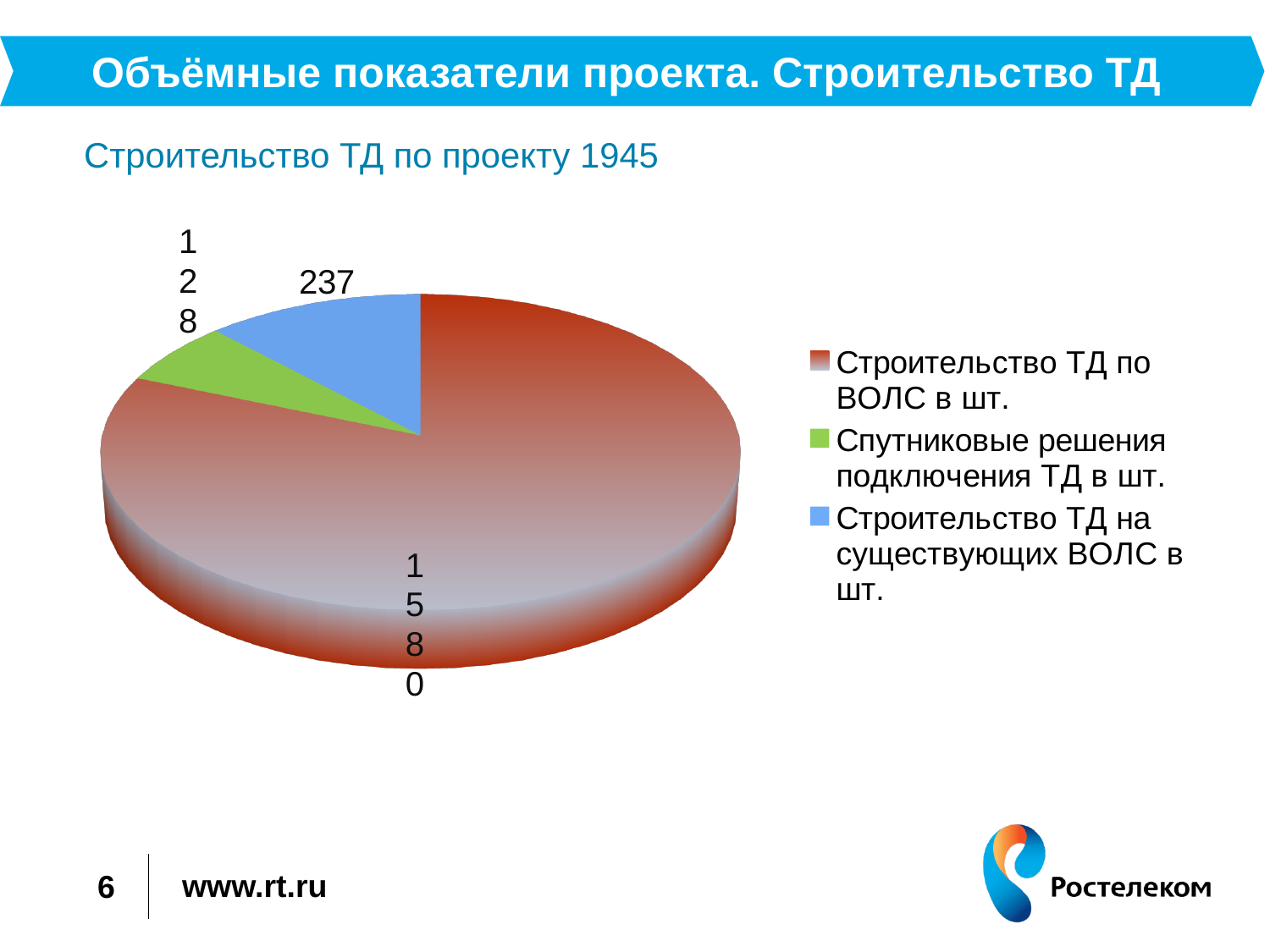
Which is larger: Строительство ТД на существующих ВОЛС в шт. or Спутниковые решения подключения ТД в шт.? Строительство ТД на существующих ВОЛС в шт. What is the value for Строительство ТД на существующих ВОЛС в шт.? 237 How many slices does the pie chart have? 3 What is the total of all slices in the pie chart? 1945 What is the difference between the values for Строительство ТД по ВОЛС в шт. and Строительство ТД на существующих ВОЛС в шт.? 1343 What colour is the slice for Спутниковые решения подключения ТД в шт.? green What is the difference between the values for Строительство ТД на существующих ВОЛС в шт. and Спутниковые решения подключения ТД в шт.? 109 Which category has the largest slice of the pie? Строительство ТД по ВОЛС в шт. What is the value for Спутниковые решения подключения ТД в шт.? 128 Which category has the smallest slice of the pie? Спутниковые решения подключения ТД в шт. What is the value for Строительство ТД по ВОЛС в шт.? 1580 What type of chart is shown on the slide? pie chart